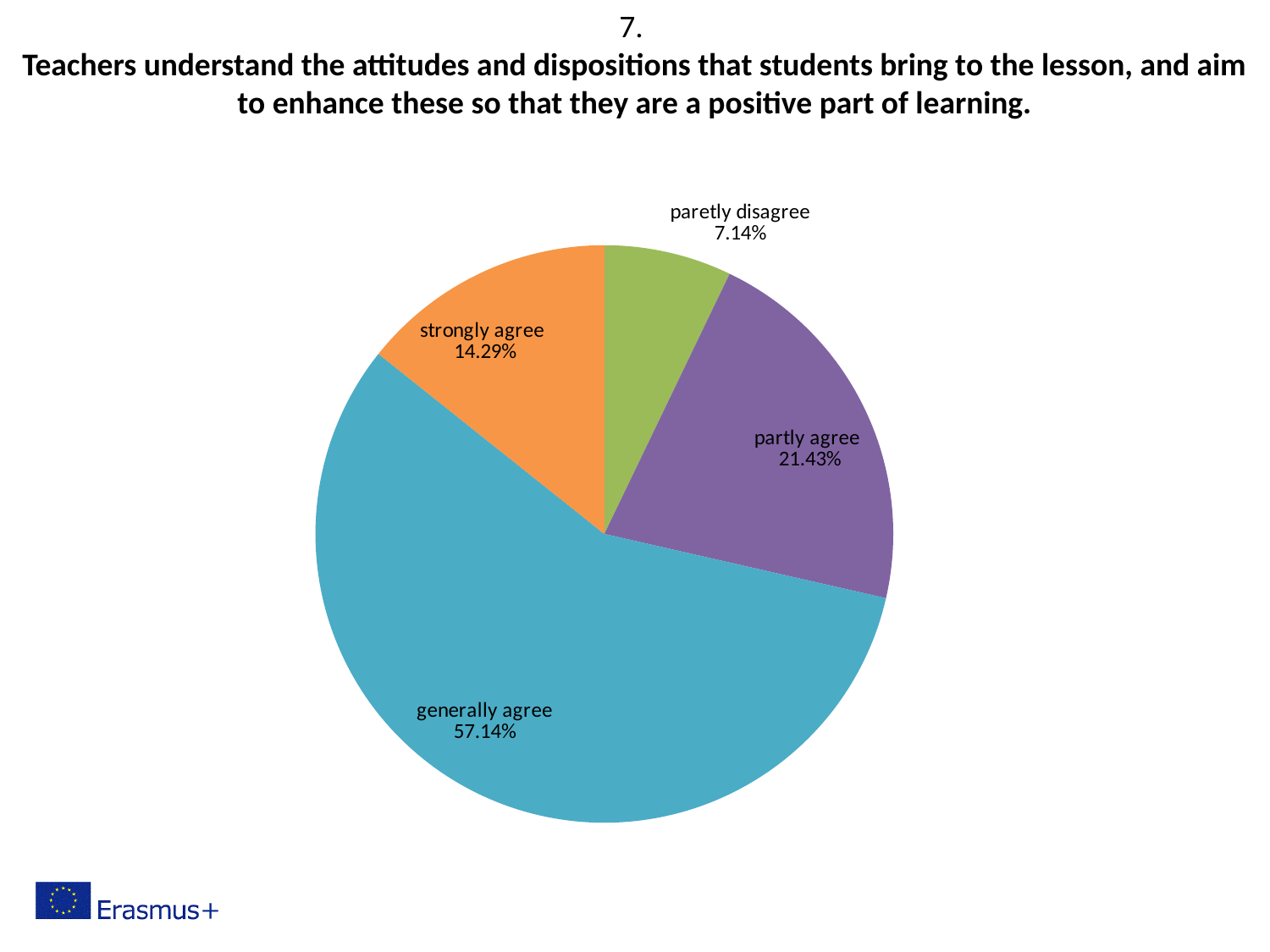
What colour is the "generally agree" slice? blue What percentage is shown for "partly agree"? 21.43% What percentage is shown for "strongly agree"? 14.29% Which category has the smallest slice of the pie? paretly disagree How many slices does the pie chart have? 4 What share of the pie is labelled "generally agree"? 57.14% What is the difference in percentage points between "strongly agree" and "paretly disagree"? 7.15 What is the difference in percentage points between "generally agree" and "partly agree"? 35.71 What percentage is shown for "paretly disagree"? 7.14% What kind of chart is shown on the slide? pie chart Which category has the largest slice of the pie? generally agree Which is larger, the share for "partly agree" or the share for "strongly agree"? partly agree